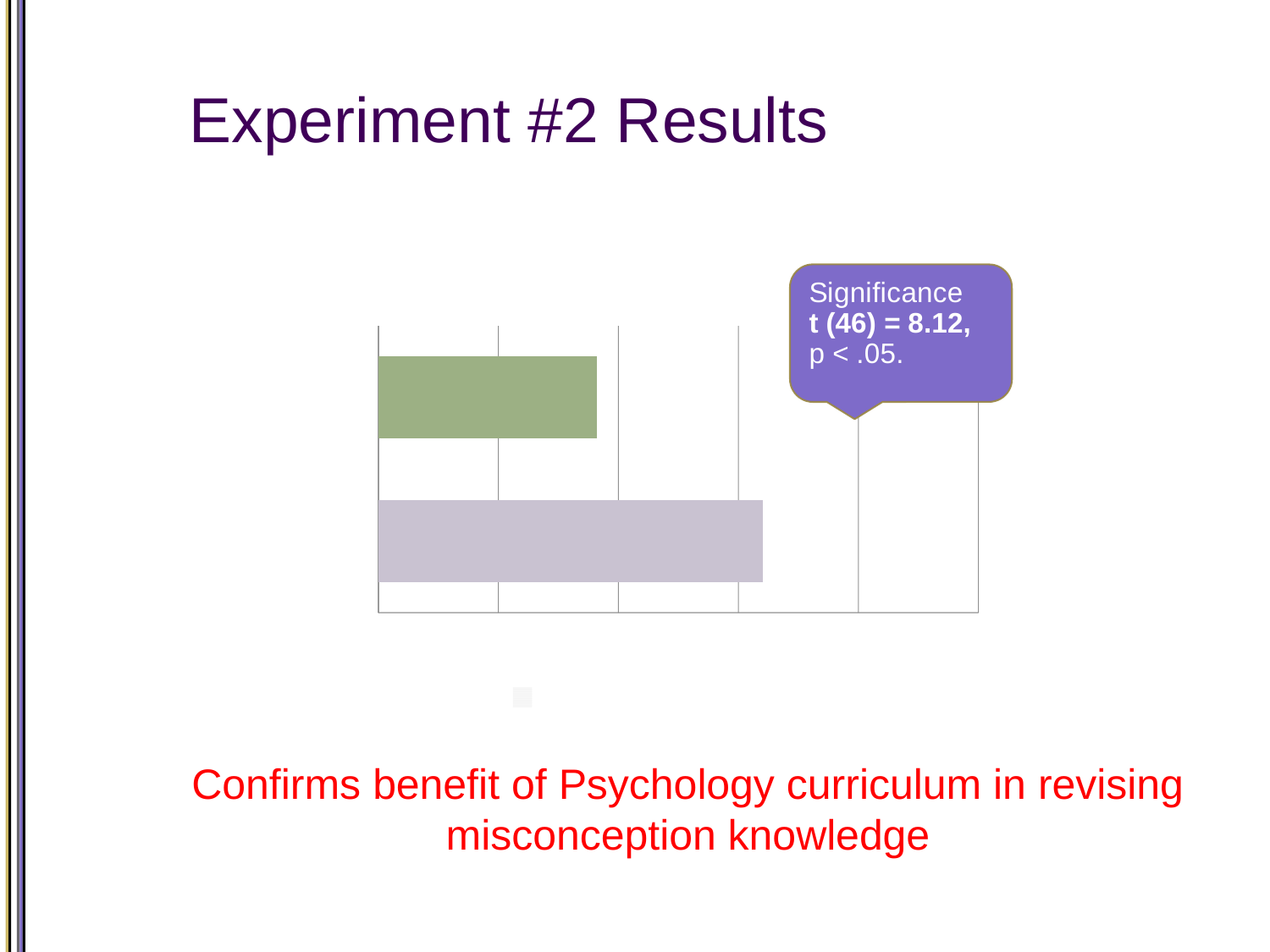
What colour is the top bar in the chart? green Which bar is the longest in the chart? the bottom (lavender) bar What kind of chart is shown on the slide? bar chart Which bar is the shortest in the chart? the top (green) bar Are the bars in the chart drawn horizontally or vertically? horizontally Which bar is longer, the top (green) bar or the bottom (lavender) bar? the bottom (lavender) bar How many bars are plotted in the chart? 2